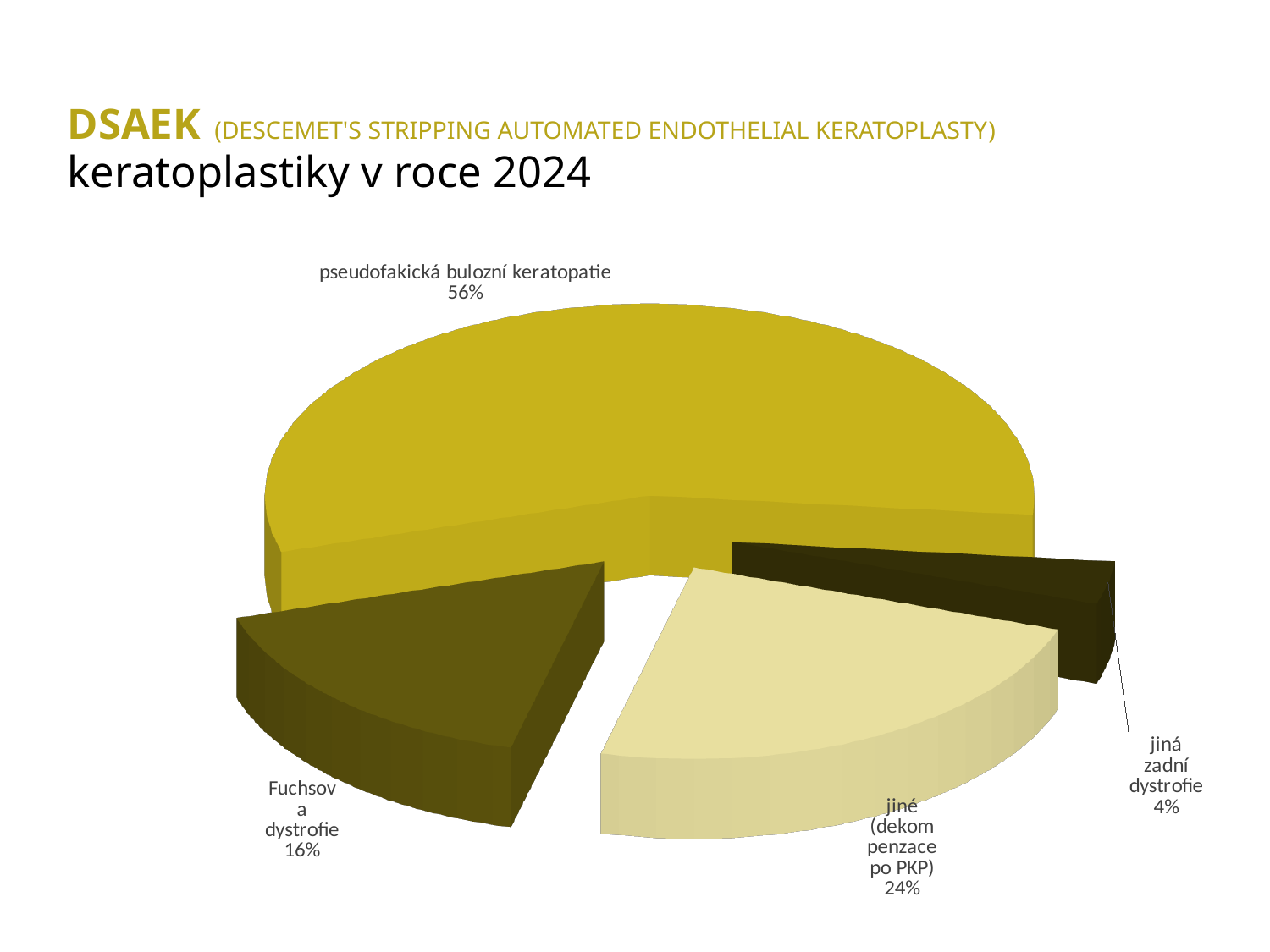
Which category has the smallest slice of the pie? jiná zadní dystrofie Which is larger: the share for Fuchsova dystrofie or the share for jiné (dekompenzace po PKP)? jiné (dekompenzace po PKP) What is the difference in percentage points between pseudofakická bulozní keratopatie and jiné (dekompenzace po PKP)? 32 Which year does the chart title say the keratoplasties are from? 2024 What share of the pie does jiné (dekompenzace po PKP) represent? 24% What share of the pie does jiná zadní dystrofie represent? 4% How many categories are shown in the pie chart? 4 What share of the pie does Fuchsova dystrofie represent? 16% What kind of chart is shown on the slide? pie chart Which category has the largest slice of the pie? pseudofakická bulozní keratopatie What is the difference in percentage points between Fuchsova dystrofie and jiná zadní dystrofie? 12